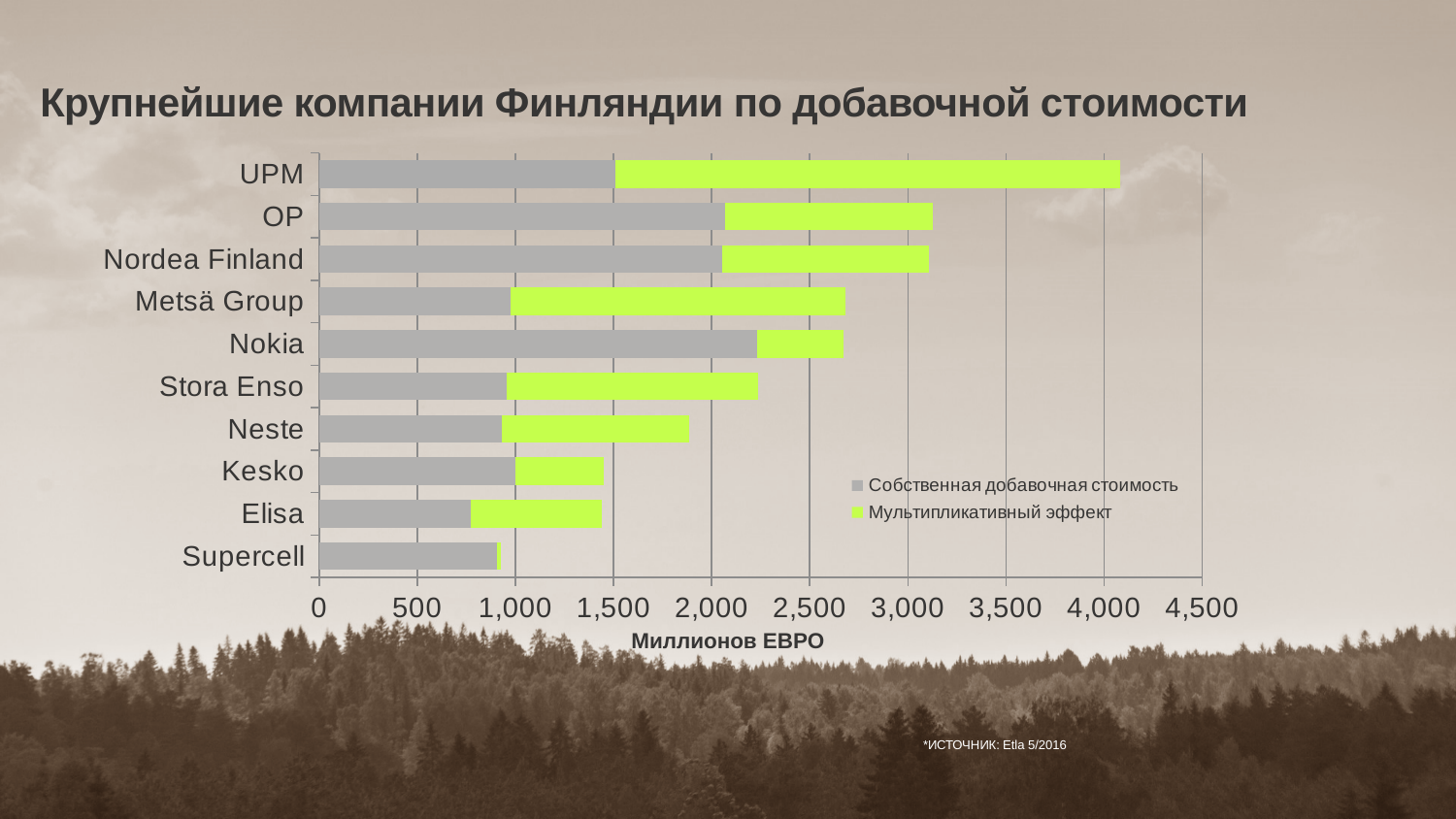
Is the total value for Neste greater or less than 2,000? less Is the 'Собственная добавочная стоимость' value for Nokia greater or less than 2,000? greater Is the total value for UPM greater or less than 3,500? greater Which company has the longest total bar? UPM What kind of chart is shown on the slide? Stacked bar chart Which has the larger 'Мультипликативный эффект' segment, Metsä Group or Nokia? Metsä Group What is the label on the horizontal axis of the chart? Миллионов ЕВРО How many series does the legend list? 2 Which company has the shortest total bar? Supercell Which has the larger 'Собственная добавочная стоимость' segment, Nokia or Stora Enso? Nokia How many companies are listed on the chart? 10